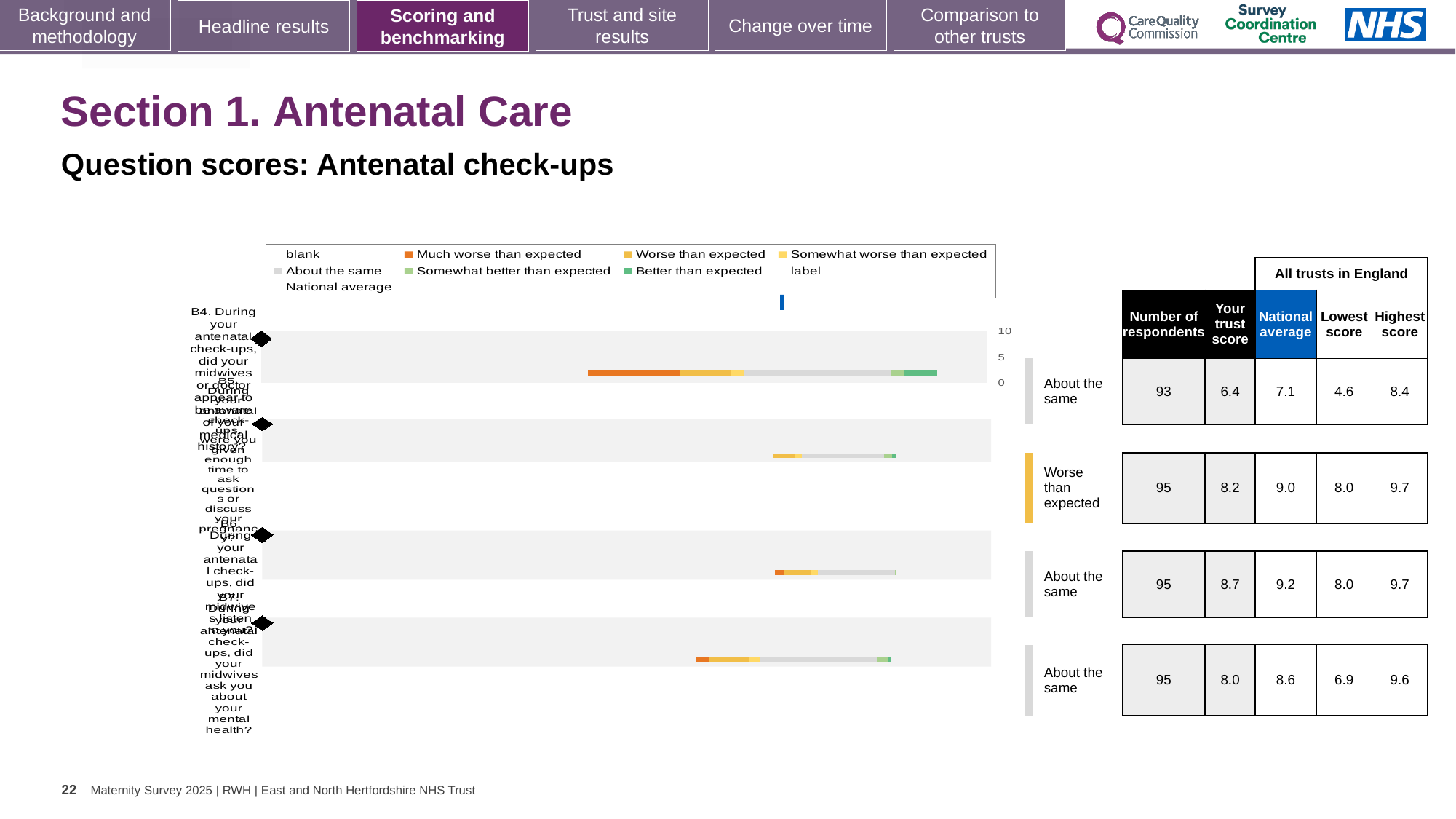
What is the national average for the second row of the table? 9.0 Which row has the lowest 'Your trust score'? the first (top) row (6.4) How many of the four rows are rated 'About the same'? 3 What is the highest score across all trusts in England for the fourth (bottom) row? 9.6 What kind of chart is shown on the slide? bar chart What is the 'Your trust score' for the row rated 'Worse than expected'? 8.2 For the first (top) row, what is the difference between the national average and the trust score? 0.7 How many question rows (bars) are plotted in the chart? 4 For the fourth (bottom) row, which is larger: the trust score or the national average? the national average (8.6) Which row has the highest 'Your trust score'? the third row (8.7) In the table next to the chart, what is the number of respondents for the first (top) row? 93 What is the lowest score across all trusts in England for the third row? 8.0